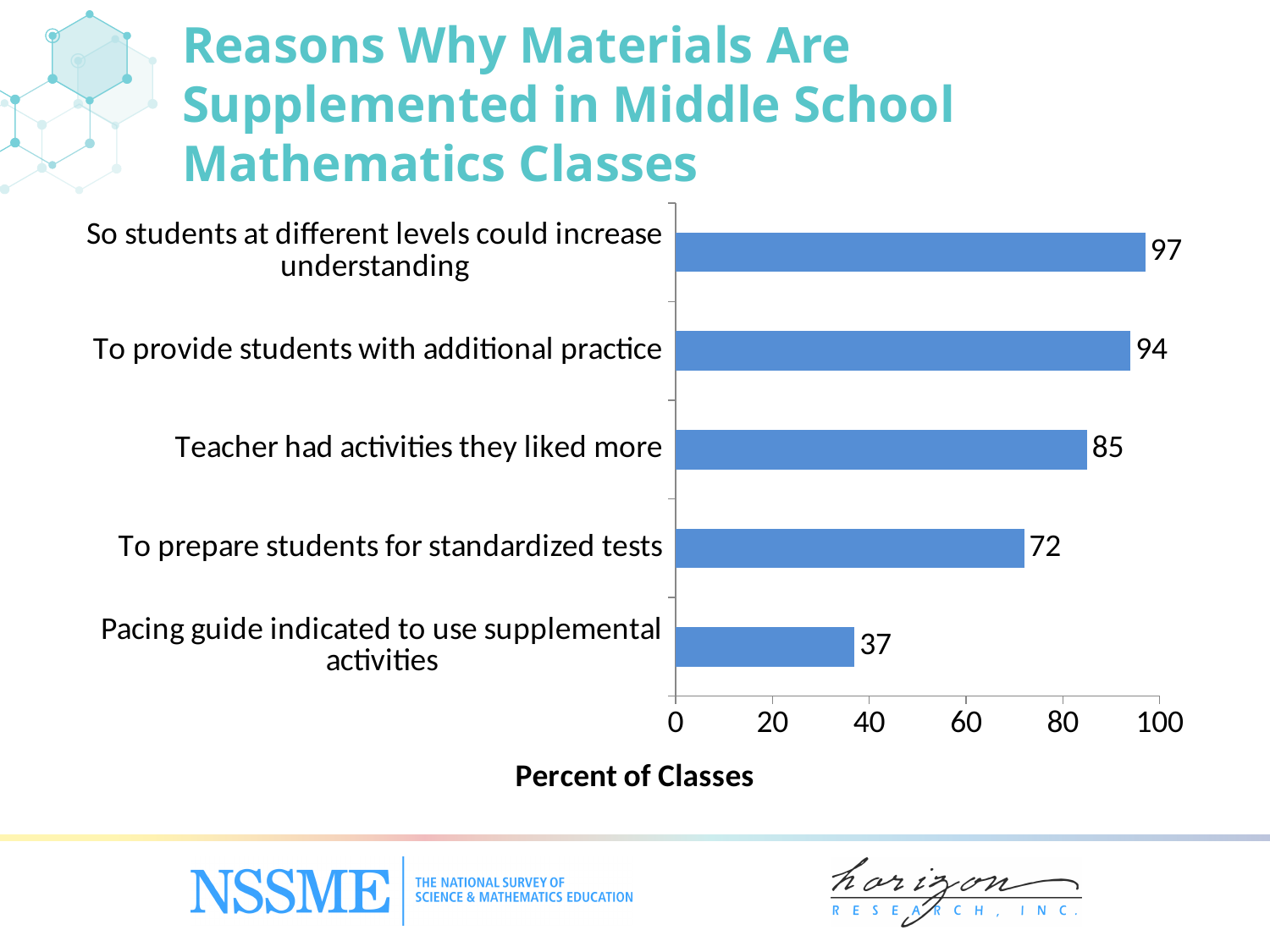
Which is larger: the value for 'Teacher had activities they liked more' or 'To prepare students for standardized tests'? Teacher had activities they liked more What kind of chart is shown on the slide? Bar chart What percent of classes supplemented materials because the teacher had activities they liked more? 85 What is the label of the horizontal axis? Percent of Classes Which reason has the highest percent of classes? So students at different levels could increase understanding What percent of classes supplemented materials so students at different levels could increase understanding? 97 What is the difference between the values for 'To prepare students for standardized tests' and 'Pacing guide indicated to use supplemental activities'? 35 Which reason has the lowest percent of classes? Pacing guide indicated to use supplemental activities Is the value for 'To prepare students for standardized tests' greater or less than 60? greater How many reasons are shown in the chart? 5 What is the value for 'To provide students with additional practice'? 94 What is the value for 'Pacing guide indicated to use supplemental activities'? 37